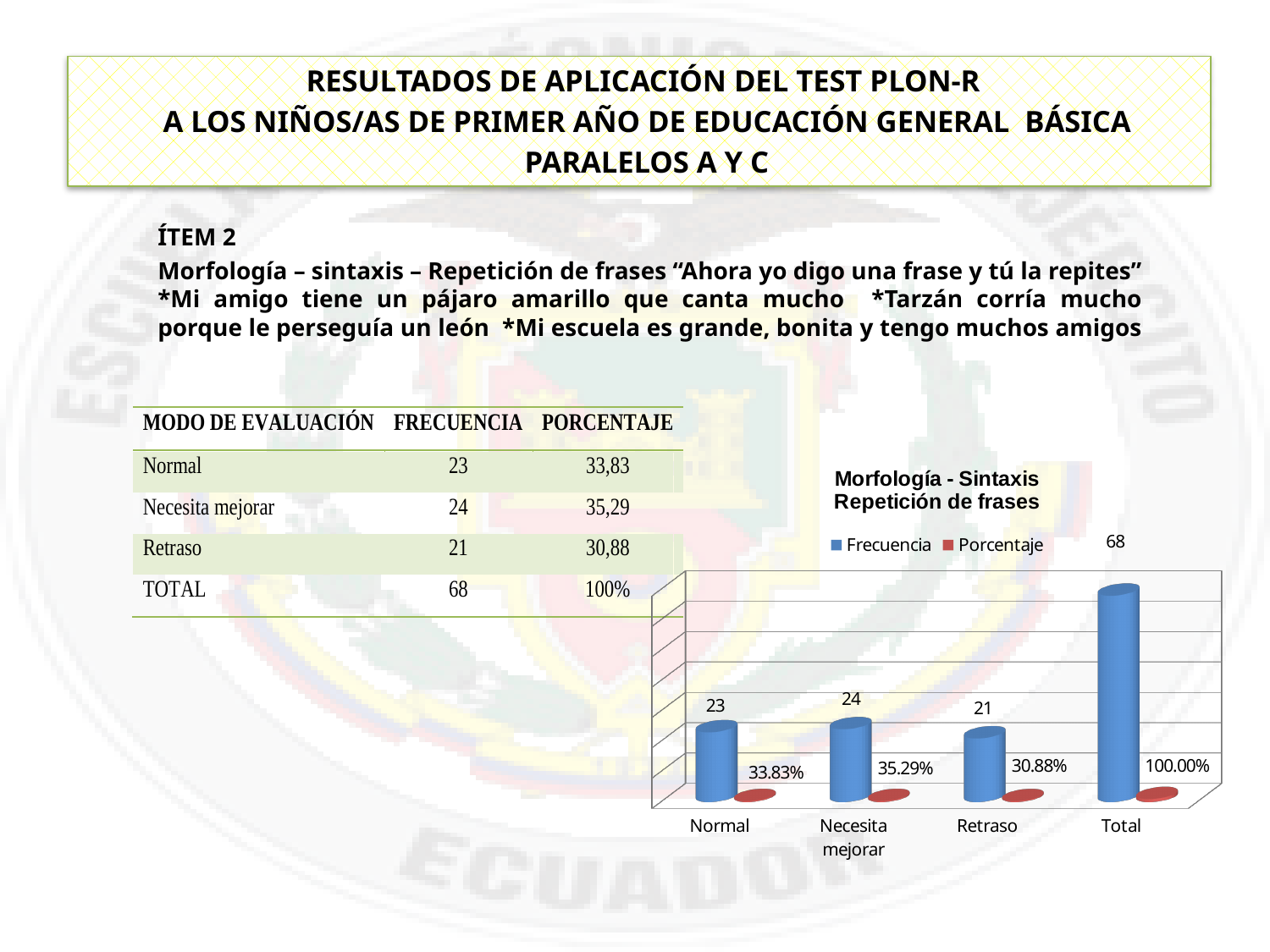
What is the Frecuencia value for Total in the chart? 68 What is the difference between the Frecuencia values for Necesita mejorar and Retraso? 3 What is the Frecuencia value for Necesita mejorar in the chart? 24 What is the title of the chart? Morfología - Sintaxis Repetición de frases What is the Porcentaje value for Retraso in the chart? 30.88% What kind of chart is shown on the slide? bar chart Which category has the lowest Frecuencia value in the chart? Retraso How many series does the chart legend list? 2 How many categories are shown on the x axis of the chart? 4 Which is larger, the Frecuencia value for Normal or for Necesita mejorar? Necesita mejorar What is the Porcentaje value for Normal in the chart? 33.83% Which category has the highest Frecuencia value in the chart? Total